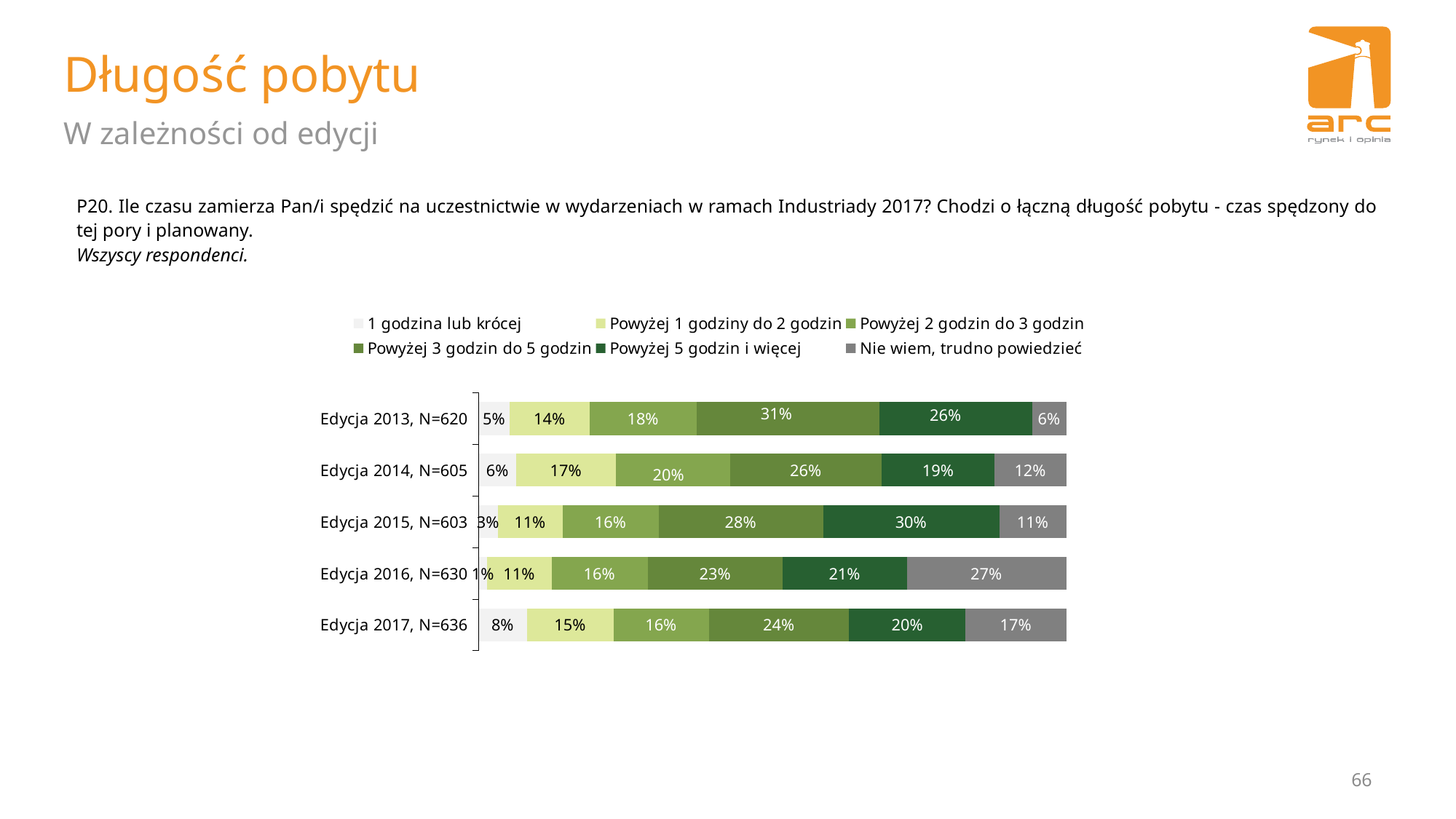
How many series does the legend list? 6 What is the value for 'Nie wiem, trudno powiedzieć' in Edycja 2016, N=630? 27% What type of chart is shown on the slide? Stacked bar chart Which edition has the lowest value for '1 godzina lub krócej'? Edycja 2016, N=630 What is the value for 'Powyżej 3 godzin do 5 godzin' in Edycja 2013, N=620? 31% What is the difference between the 'Powyżej 5 godzin i więcej' values for Edycja 2013, N=620 and Edycja 2014, N=605? 7% What is the value for 'Powyżej 5 godzin i więcej' in Edycja 2015, N=603? 30% Which is larger: 'Powyżej 1 godziny do 2 godzin' in Edycja 2014, N=605 or in Edycja 2017, N=636? Edycja 2014, N=605 What is the value for '1 godzina lub krócej' in Edycja 2017, N=636? 8% Which legend entry is shown in grey? Nie wiem, trudno powiedzieć How many editions (categories) are shown in the chart? 5 Which edition has the highest value for 'Nie wiem, trudno powiedzieć'? Edycja 2016, N=630